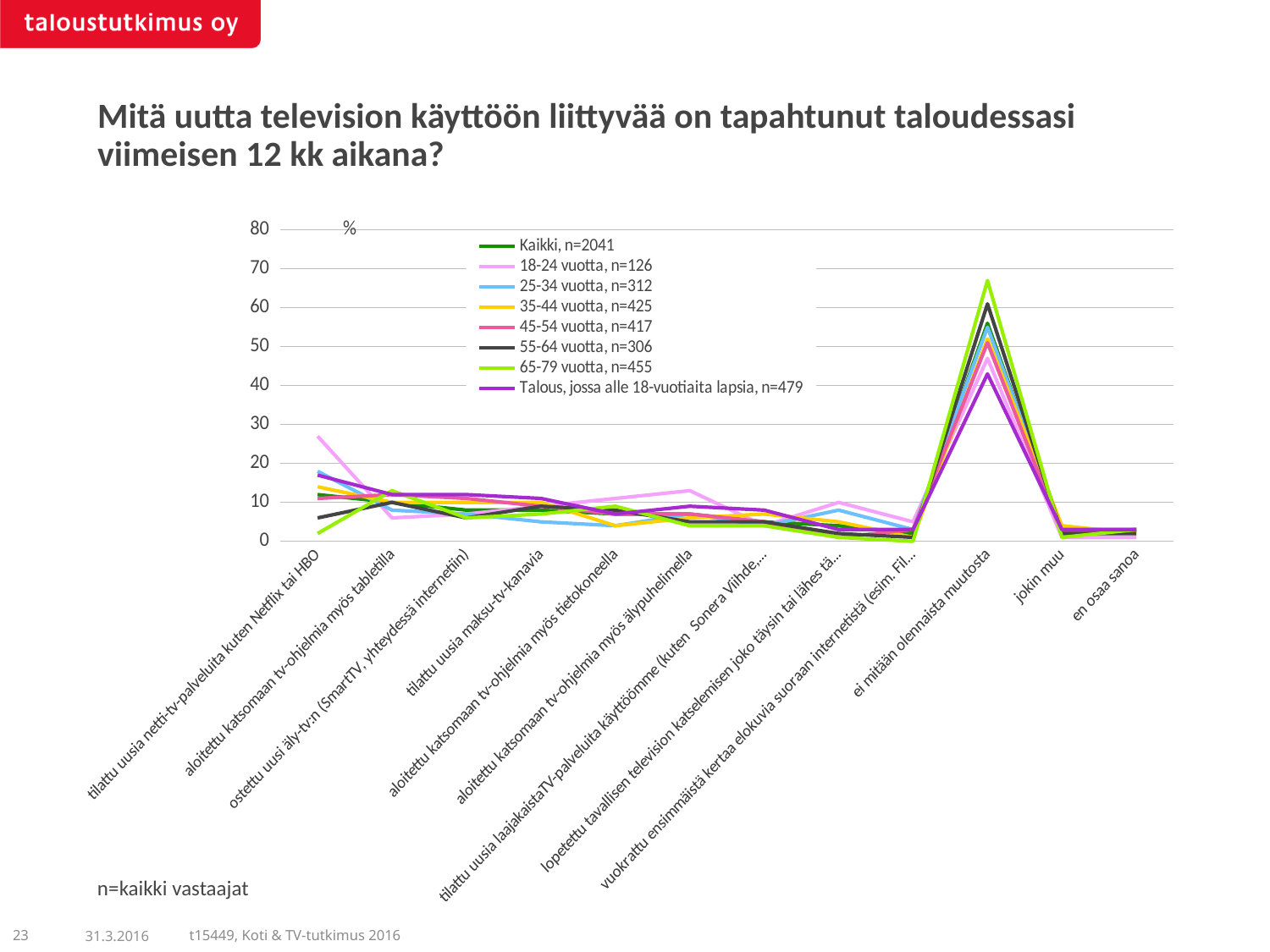
How many series does the legend list? 8 Which series has the highest value for 'tilattu uusia netti-tv-palveluita kuten Netflix tai HBO'? 18-24 vuotta, n=126 Is the value for '65-79 vuotta, n=455' at 'tilattu uusia netti-tv-palveluita kuten Netflix tai HBO' greater or less than 10? less What kind of chart is shown on the slide? line chart How many categories are shown along the x axis? 12 Which series has the highest value for 'ei mitään olennaista muutosta'? 65-79 vuotta, n=455 Is the value for '65-79 vuotta, n=455' at 'ei mitään olennaista muutosta' greater or less than 60? greater Which category has the highest values for all series? ei mitään olennaista muutosta Is the value for '18-24 vuotta, n=126' at 'tilattu uusia netti-tv-palveluita kuten Netflix tai HBO' greater or less than 20? greater What is the sample size (n) for the 'Kaikki' series in the legend? 2041 At 'tilattu uusia netti-tv-palveluita kuten Netflix tai HBO', which is larger: the value for '18-24 vuotta, n=126' or for '65-79 vuotta, n=455'? 18-24 vuotta, n=126